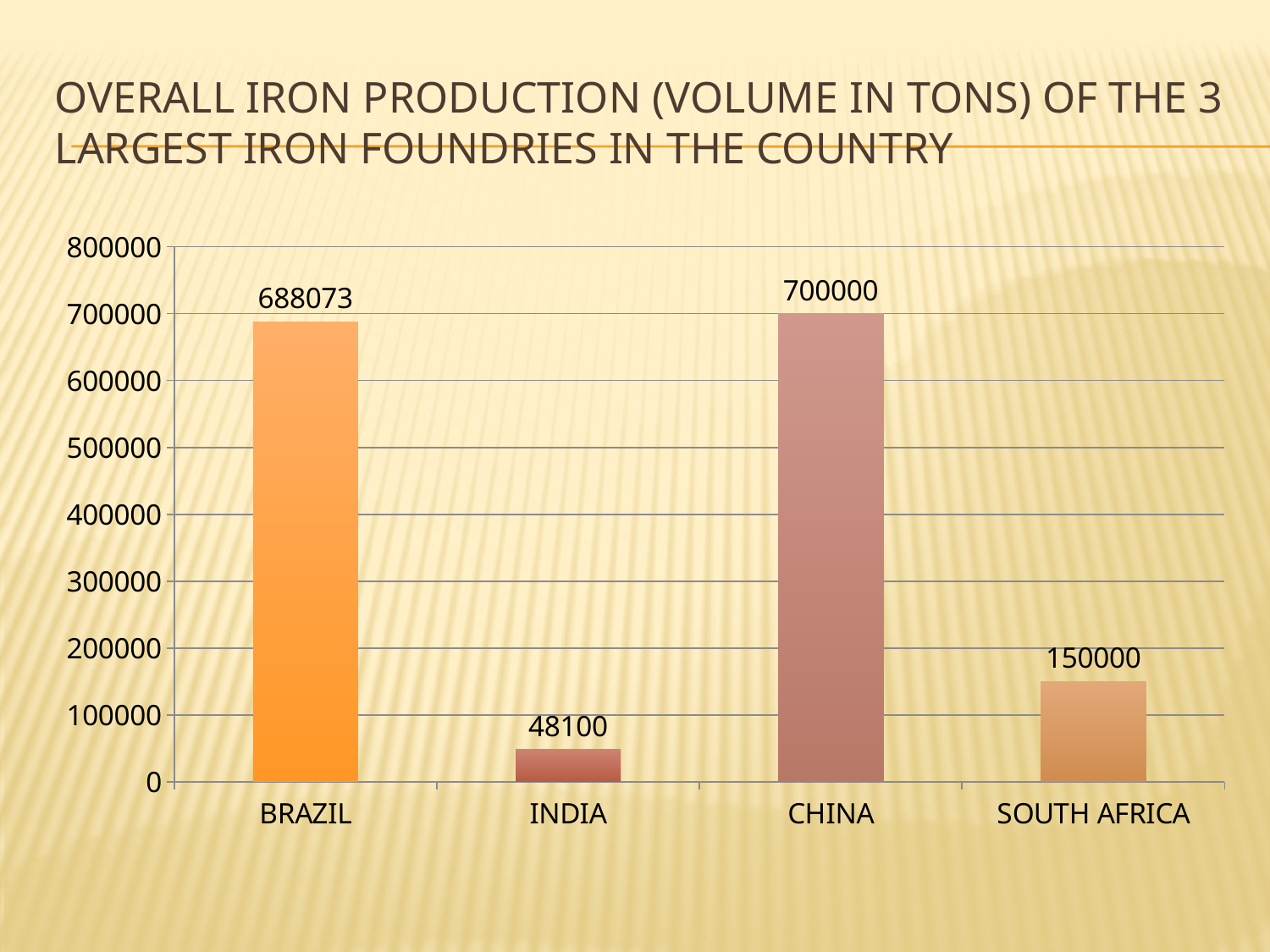
Which is larger, the value for Brazil or the value for South Africa? Brazil What is the title of the slide? Overall iron production (volume in tons) of the 3 largest iron foundries in the country Which country has the lowest iron production? India What is the iron production value for China? 700000 Which country has the highest iron production? China What is the difference between China's and Brazil's iron production? 11927 What is the iron production value for Brazil? 688073 What is the iron production value for South Africa? 150000 What is the iron production value for India? 48100 How many countries are shown on the chart? 4 What is the difference between South Africa's and India's iron production? 101900 What kind of chart is shown on the slide? Bar chart